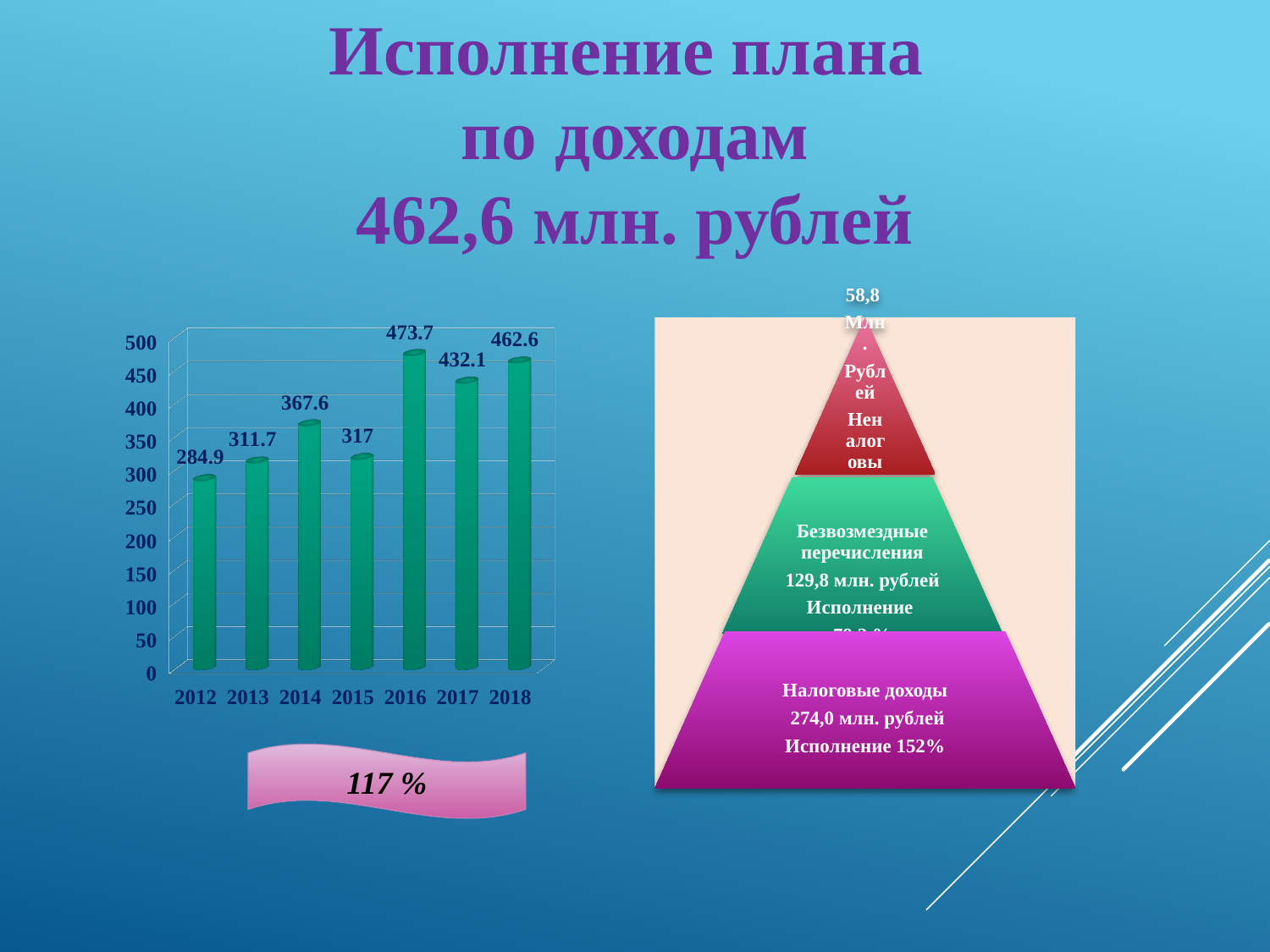
How many years are shown in the bar chart? 7 In the bar chart, what is the value for 2012? 284.9 In the bar chart, which year has the larger value, 2014 or 2015? 2014 In the bar chart, which year has the lowest value? 2012 In the bar chart, which year has the highest value? 2016 In the bar chart, what is the difference between the values for 2016 and 2015? 156.7 In the bar chart, do the values rise or fall from 2012 to 2014? rise In the bar chart, is the value for 2013 greater or less than 300? greater In the bar chart, what is the value for 2016? 473.7 In the bar chart, what is the value for 2018? 462.6 What kind of chart is shown on the left of the slide? bar chart In the bar chart, what is the difference between the values for 2018 and 2017? 30.5